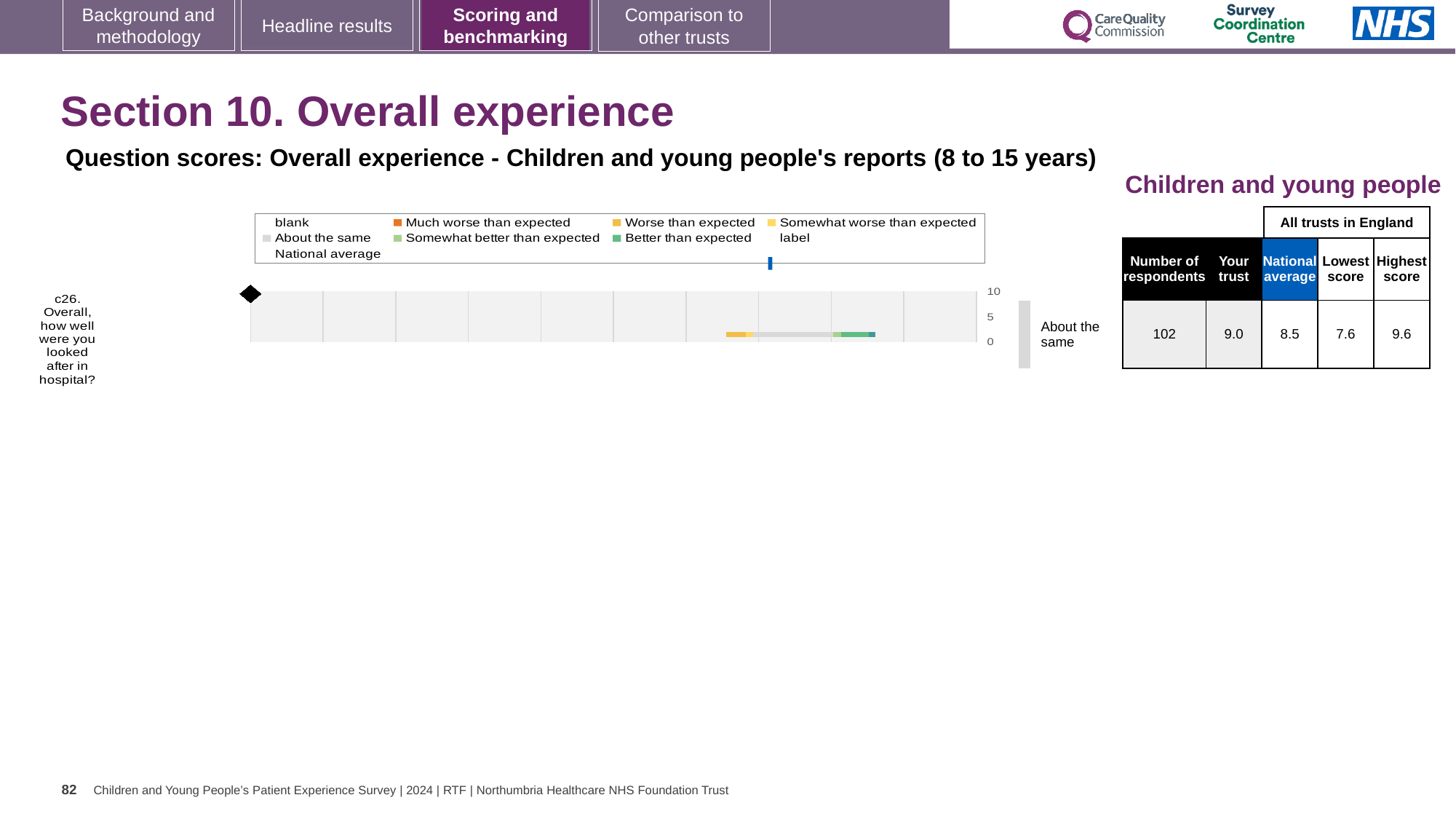
What is the maximum value shown on the chart's score axis? 10 Is the right-hand end of the bar for c26 greater or less than 10? less How many questions (categories) are plotted on the chart? 1 According to the table beside the chart, what is the 'Your trust' score for c26? 9.0 What benchmark category is written next to the bar for question c26? About the same According to the table beside the chart, what is the highest score among all trusts in England for c26? 9.6 What kind of chart is shown for question c26? bar chart According to the table beside the chart, how many respondents answered c26? 102 According to the table beside the chart, what is the national average score for c26? 8.5 Which is larger for c26: the 'Your trust' score or the national average? Your trust Is the left-hand end of the bar for c26 greater or less than 5? greater What is the difference between the highest score (9.6) and the lowest score (7.6) for c26? 2.0